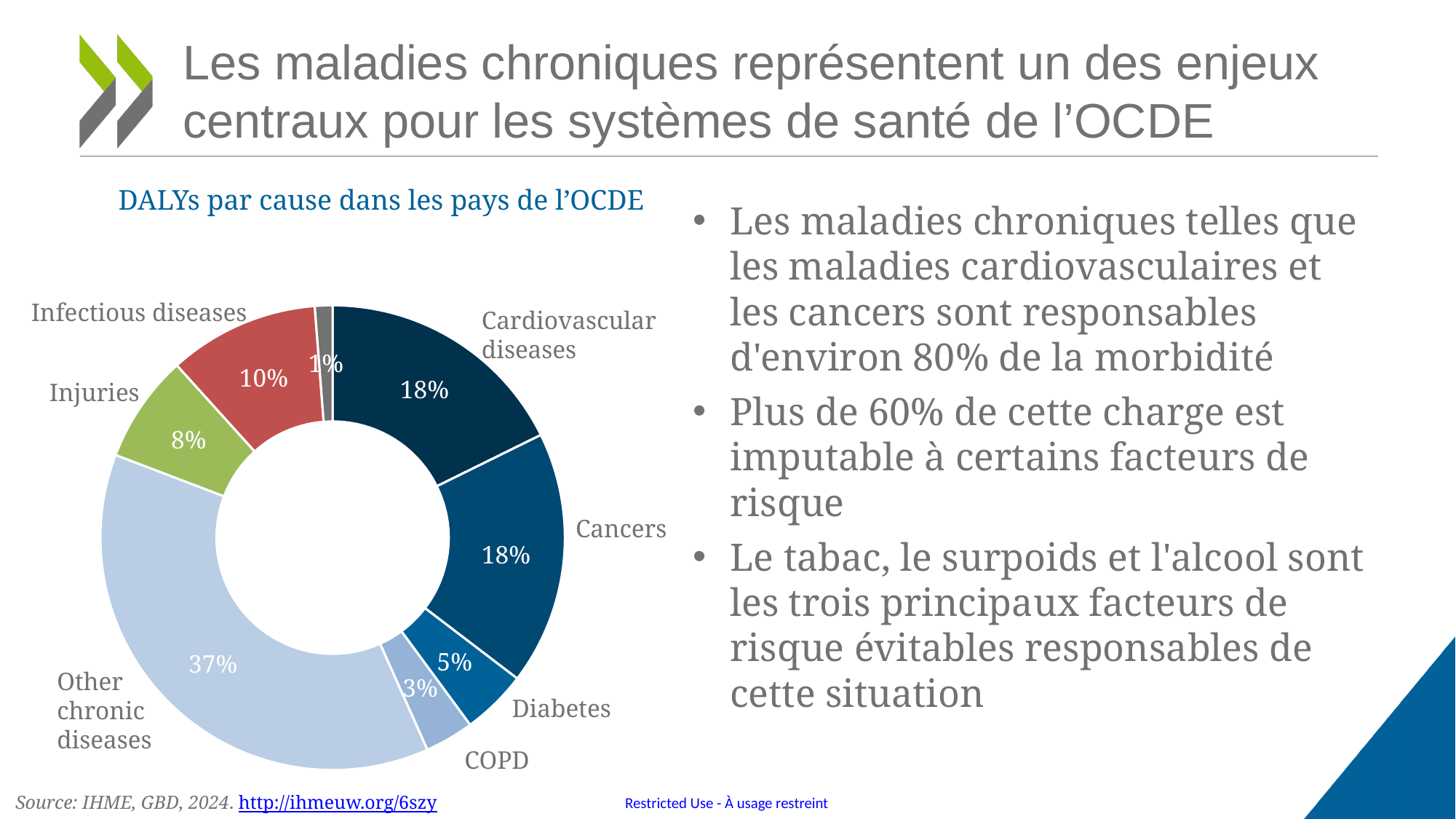
What is the value for Infectious diseases? 10% What is the title of the chart on the slide? DALYs par cause dans les pays de l'OCDE What share of DALYs is attributed to Other chronic diseases in the donut chart? 37% What percentage is shown for COPD? 3% What is the difference in percentage points between Other chronic diseases and Cardiovascular diseases? 19% What is the difference between the Infectious diseases share and the Injuries share? 2% Which is larger, the share for Diabetes or the share for COPD? Diabetes What is the value shown for Diabetes? 5% What percentage does the Cardiovascular diseases slice show? 18% What is the combined share of Cardiovascular diseases and Cancers? 36% Which cause accounts for the largest share of DALYs in the chart? Other chronic diseases What kind of chart is used to show DALYs by cause? doughnut chart